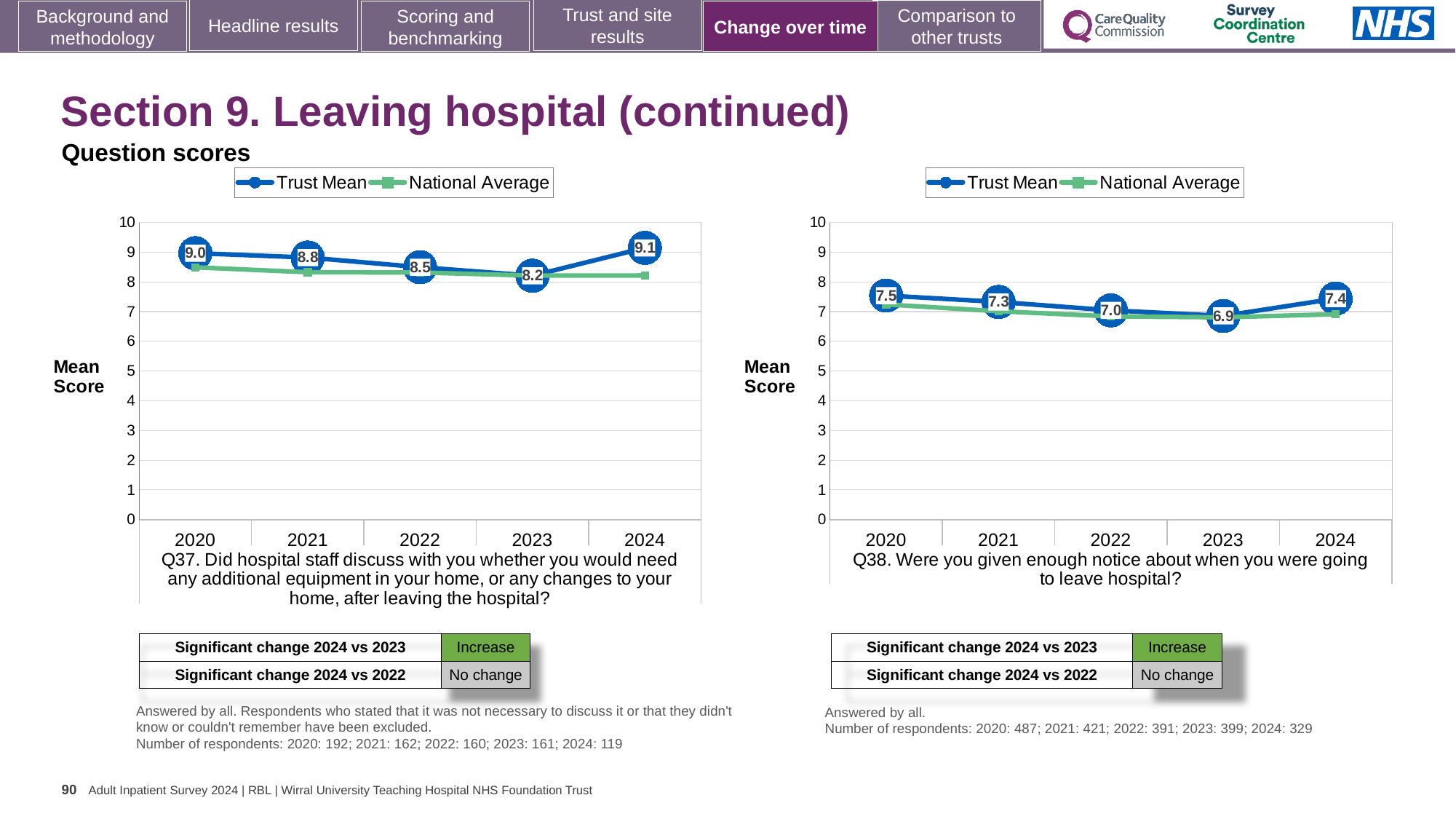
In the Q37 chart (left), what is the Trust Mean score for 2024? 9.1 In the Q38 chart (right), which year has the highest Trust Mean score? 2020 In the Q37 chart (left), does the Trust Mean score rise or fall from 2020 to 2023? Fall In the Q38 chart (right), which is larger: the Trust Mean score for 2021 or for 2024? 2024 In the Q37 chart (left), which year has the lowest Trust Mean score? 2023 In the Q37 chart (left), what is the difference between the Trust Mean scores for 2024 and 2023? 0.9 In the Q37 chart (left), is the National Average value for 2024 greater or less than 9? less In the Q38 chart (right), what is the difference between the Trust Mean scores for 2020 and 2023? 0.6 In the Q38 chart (right), what is the Trust Mean score for 2020? 7.5 What kind of chart is the Q38 chart (right)? Line chart How many series does the legend of the Q37 chart (left) list? 2 How many years are plotted on the x axis of the Q38 chart (right)? 5